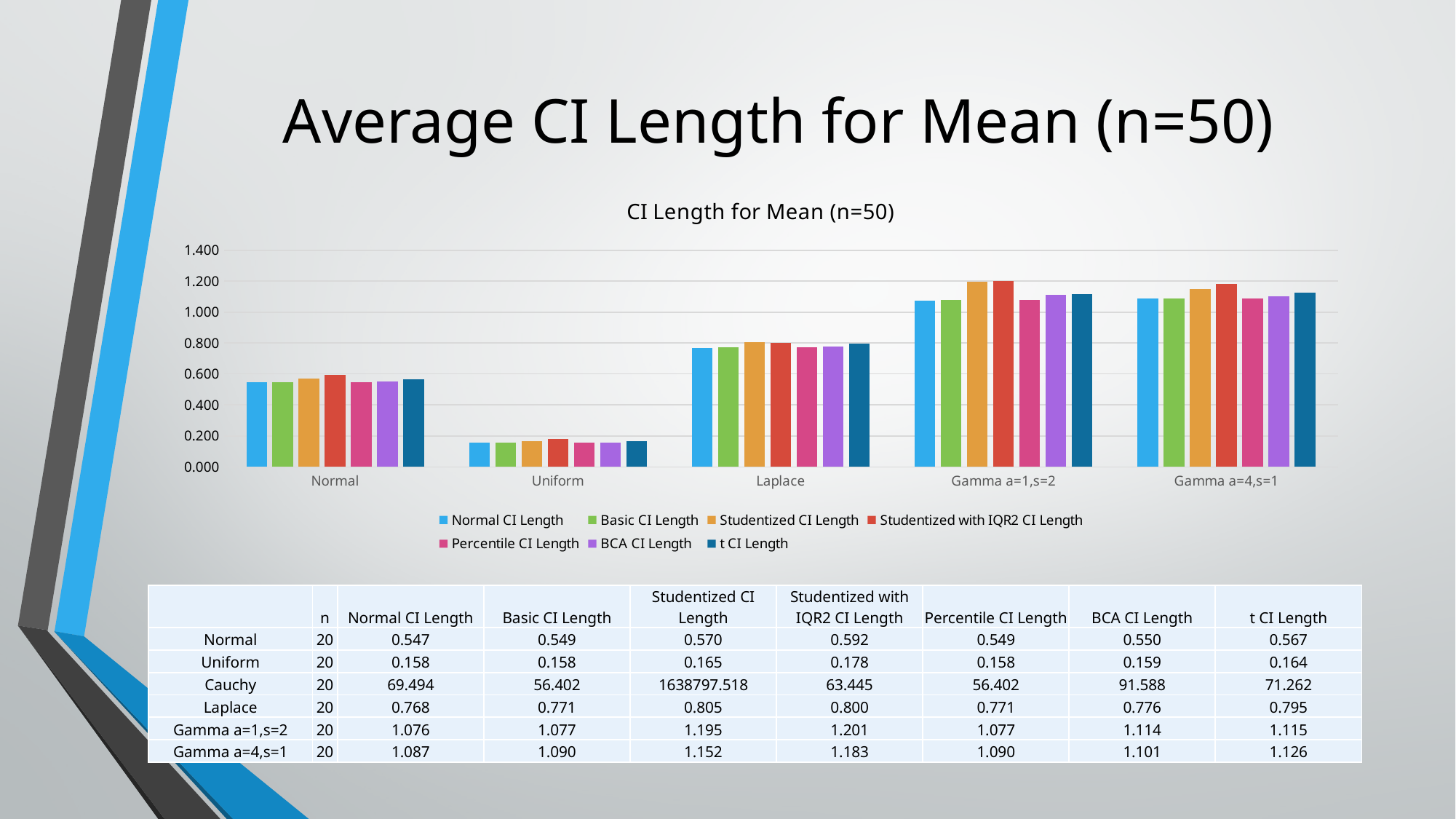
What is the Normal CI Length for Laplace? 0.768 Which distribution category has the lowest CI lengths in the chart? Uniform What kind of chart is shown on the slide? bar chart Is the Normal CI Length for Laplace greater or less than 0.800? less Is the Studentized CI Length for Gamma a=1,s=2 greater or less than 1.000? greater What is the Studentized with IQR2 CI Length for Gamma a=1,s=2? 1.201 What is the difference between the Studentized with IQR2 CI Length and the Normal CI Length for Gamma a=1,s=2? 0.125 What is the title of the chart? CI Length for Mean (n=50) How many distribution categories are shown on the chart's x axis? 5 How many series does the chart legend list? 7 For the Normal distribution, which is larger: the Studentized with IQR2 CI Length or the Normal CI Length? Studentized with IQR2 CI Length What is the t CI Length for Uniform? 0.164